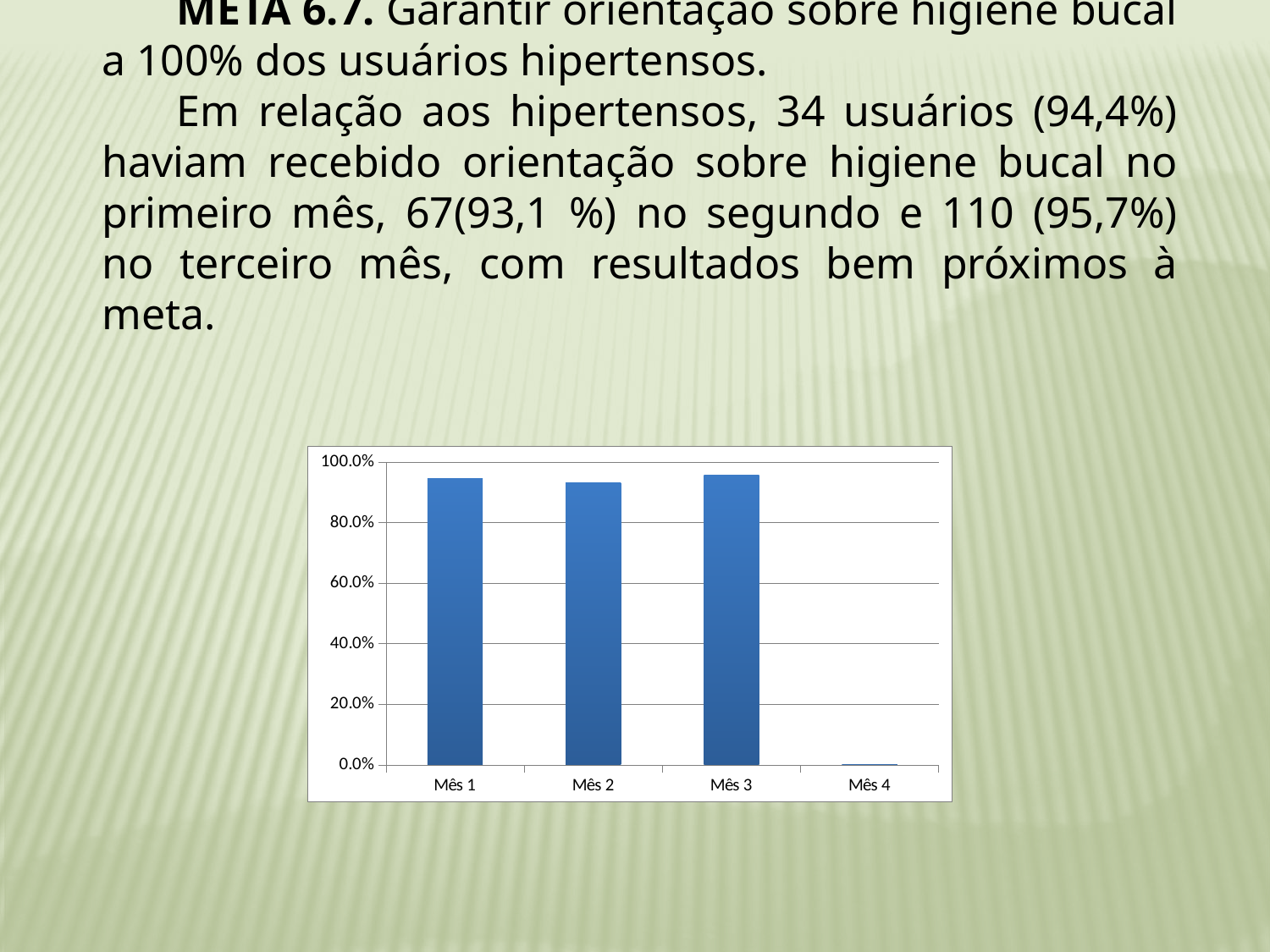
What colour are the bars in the chart? blue What kind of chart is shown on the slide? bar chart What is the highest tick label shown on the y axis of the chart? 100.0% Is the value for Mês 1 greater or less than 80.0%? greater Which is larger, the value for Mês 1 or the value for Mês 4? Mês 1 Is the value for Mês 2 greater or less than 80.0%? greater Which is larger, the value for Mês 3 or the value for Mês 2? Mês 3 Which category has the lowest value in the chart? Mês 4 Is the value for Mês 4 greater or less than 20.0%? less How many categories are shown on the x axis of the chart? 4 Which is larger, the value for Mês 3 or the value for Mês 4? Mês 3